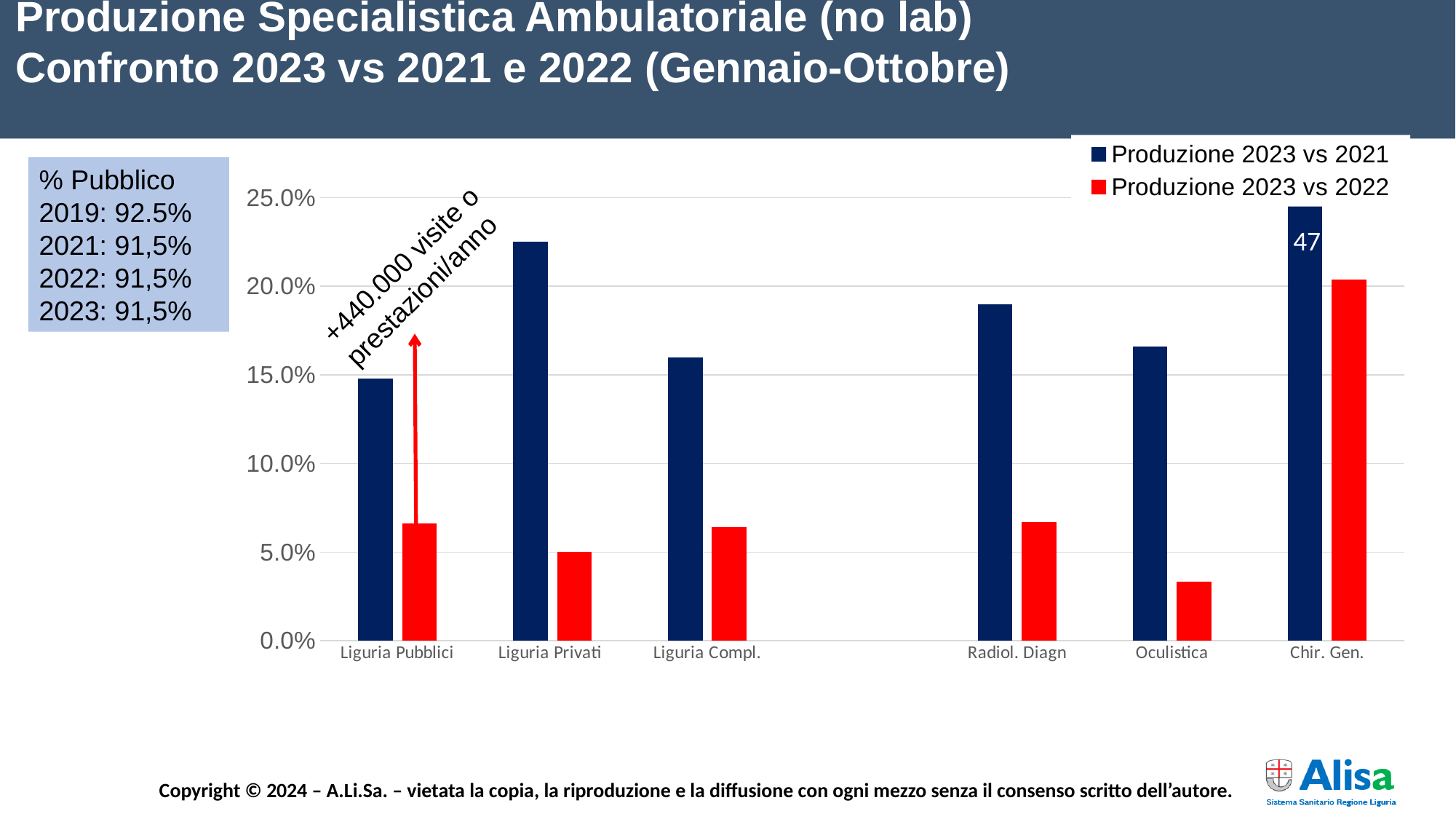
Is the value for Radiol. Diagn in the series Produzione 2023 vs 2021 greater or less than 15.0%? greater How many series does the legend list? 2 What kind of chart is shown on the slide? Bar chart Which category has the highest value for the series Produzione 2023 vs 2022? Chir. Gen. Is the value for Oculistica in the series Produzione 2023 vs 2022 greater or less than 5.0%? less Which colour represents the series Produzione 2023 vs 2022 in the chart? Red Which category has the lowest value for the series Produzione 2023 vs 2022? Oculistica For the series Produzione 2023 vs 2021, which is larger: Liguria Privati or Liguria Pubblici? Liguria Privati For the series Produzione 2023 vs 2022, which is larger: Liguria Privati or Oculistica? Liguria Privati Which category has the highest value for the series Produzione 2023 vs 2021? Chir. Gen. How many categories are shown on the x axis of the chart? 6 Is the value for Liguria Privati in the series Produzione 2023 vs 2021 greater or less than 20.0%? greater